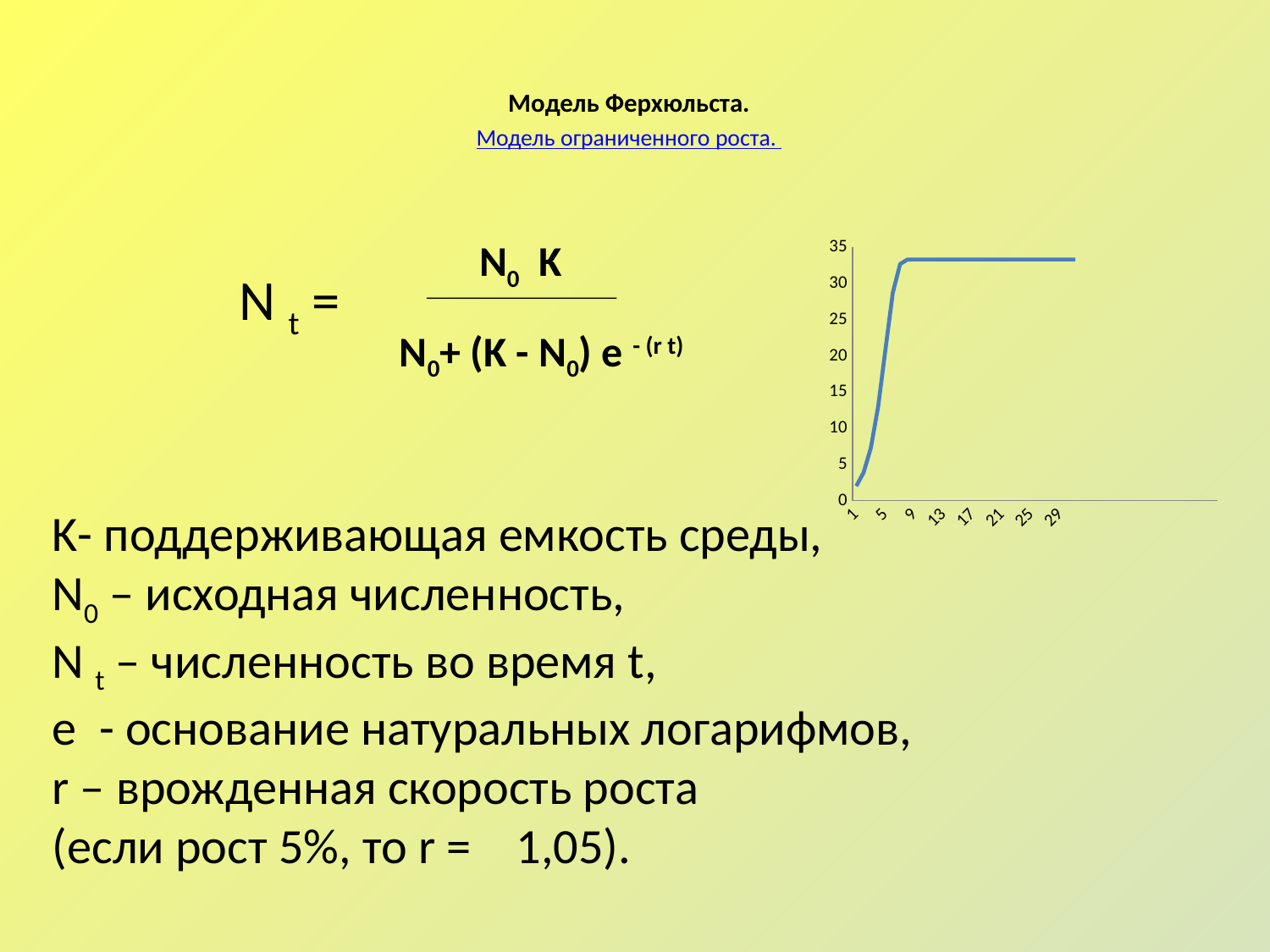
Is the value of the line at x = 13 greater or less than 25? greater What is the last tick label shown on the x axis of the chart? 29 Does the plotted line rise or fall as the x axis increases from 1 to 9? rise After about x = 9, does the line keep rising, fall, or stay flat? stay flat Is the value of the line at x = 1 greater or less than 5? less What kind of chart is shown on the slide? line chart Is the value of the line at x = 29 greater or less than 30? greater Which is larger, the value of the line at x = 1 or at x = 29? x = 29 How many tick labels are shown on the x axis of the chart? 8 What is the highest value labelled on the y axis of the chart? 35